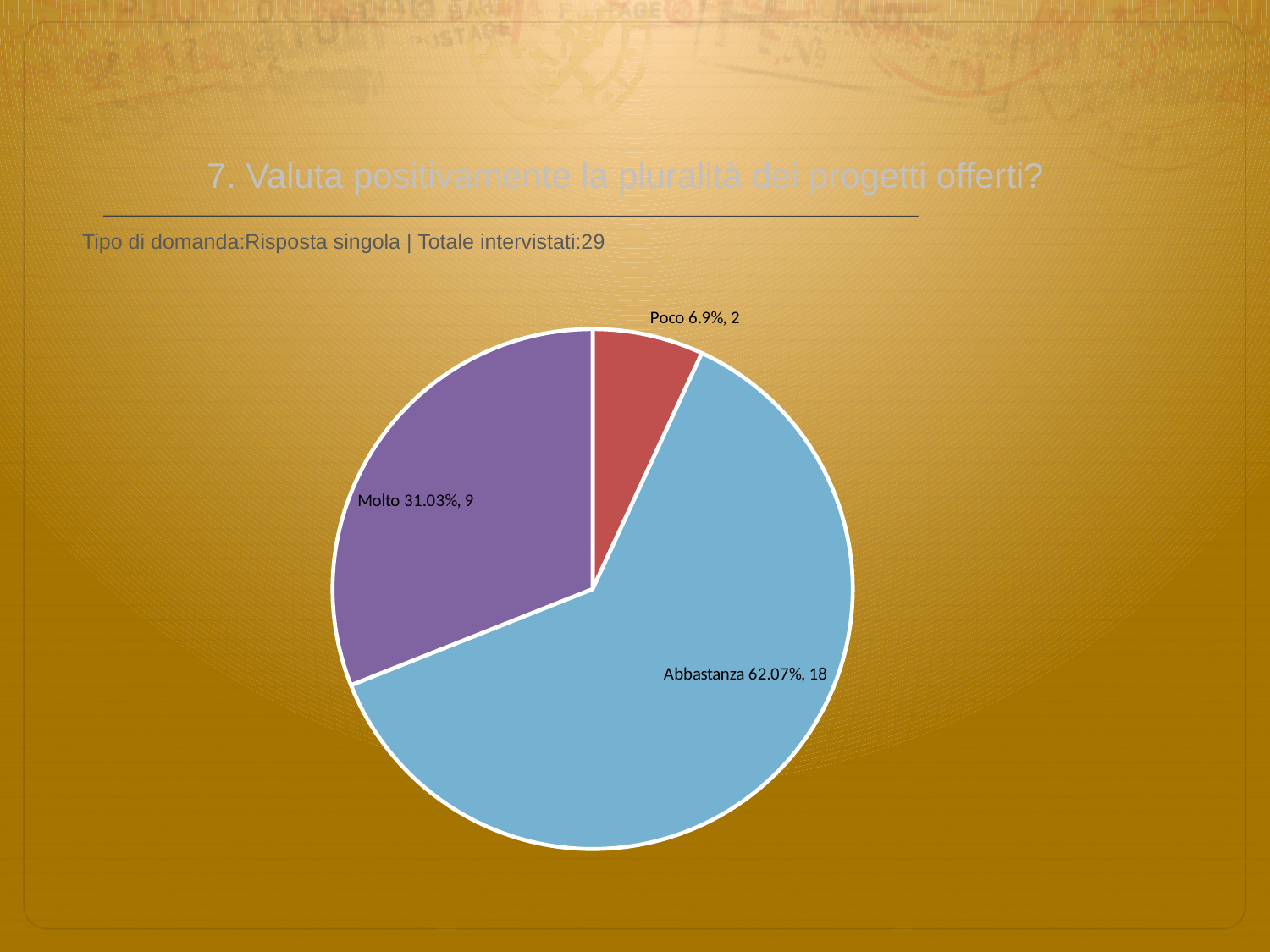
How many respondents answered Abbastanza? 18 Which category has the smallest slice of the pie? Poco Which category has the largest slice of the pie? Abbastanza What percentage share does the Poco slice have? 6.9% What percentage share does the Abbastanza slice have? 62.07% Which slice is larger, Molto or Poco? Molto What kind of chart is shown on the slide? pie chart How many slices does the pie chart have? 3 What is the difference in respondent count between Abbastanza and Molto? 9 How many respondents answered Molto? 9 What percentage share does the Molto slice have? 31.03% How many respondents answered Poco? 2